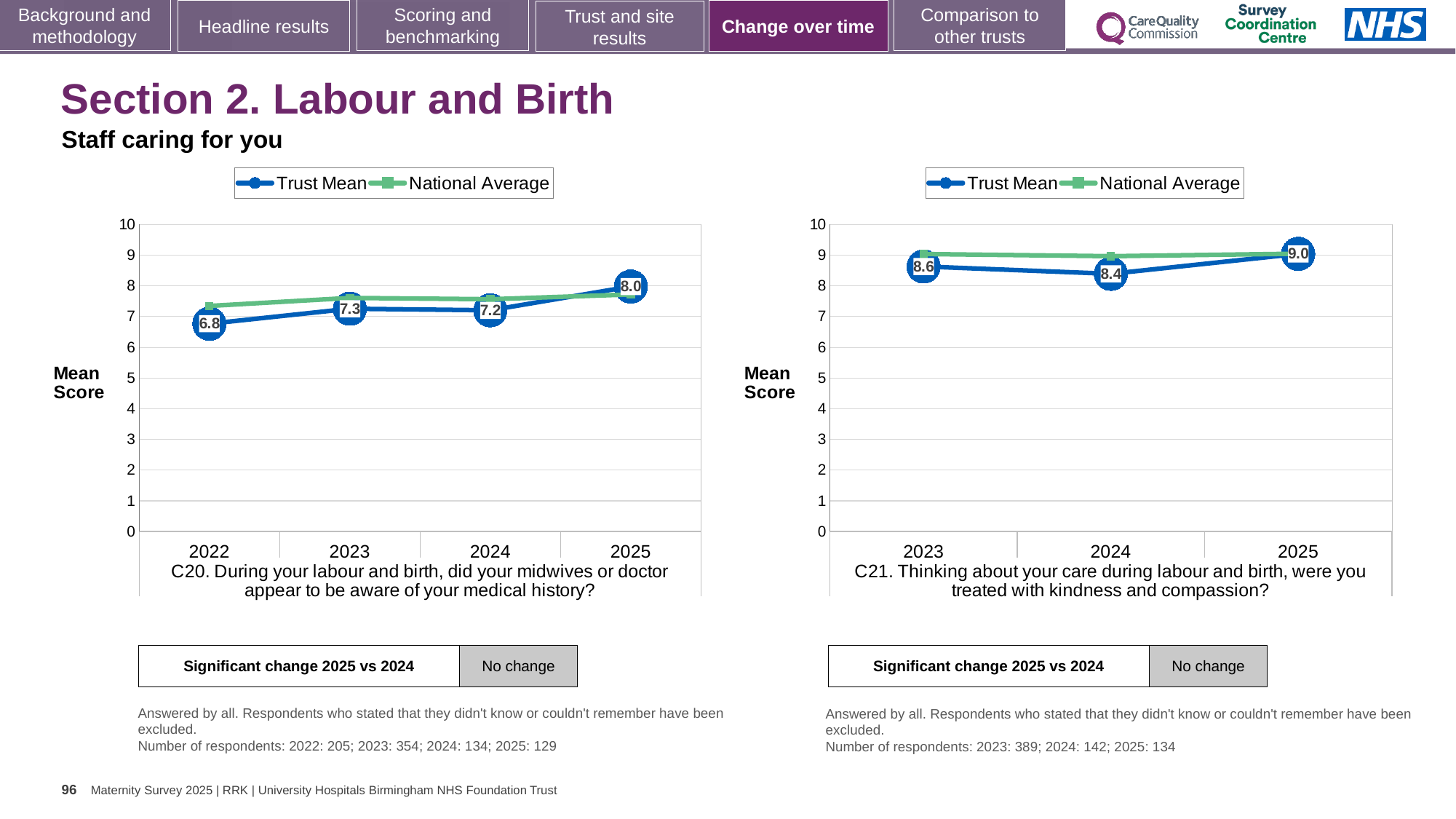
In the C21 chart on the right, which is larger, the Trust Mean for 2023 or the Trust Mean for 2025? 2025 In the C21 chart on the right, does the Trust Mean rise or fall from 2024 to 2025? rise How many years are plotted on the x axis of the C21 chart on the right? 3 What kind of chart is the C21 chart on the right? line chart In the C21 chart on the right, what is the Trust Mean for 2024? 8.4 In the C21 chart on the right, which year has the lowest Trust Mean? 2024 In the C20 chart on the left, is the National Average for 2022 greater or less than 7? greater In the C20 chart on the left, what is the Trust Mean for 2025? 8.0 In the C20 chart on the left, which year has the highest Trust Mean? 2025 How many series does the legend of the C20 chart on the left list? 2 In the C20 chart on the left, what is the Trust Mean for 2022? 6.8 In the C20 chart on the left, what is the difference between the Trust Mean for 2025 and the Trust Mean for 2022? 1.2